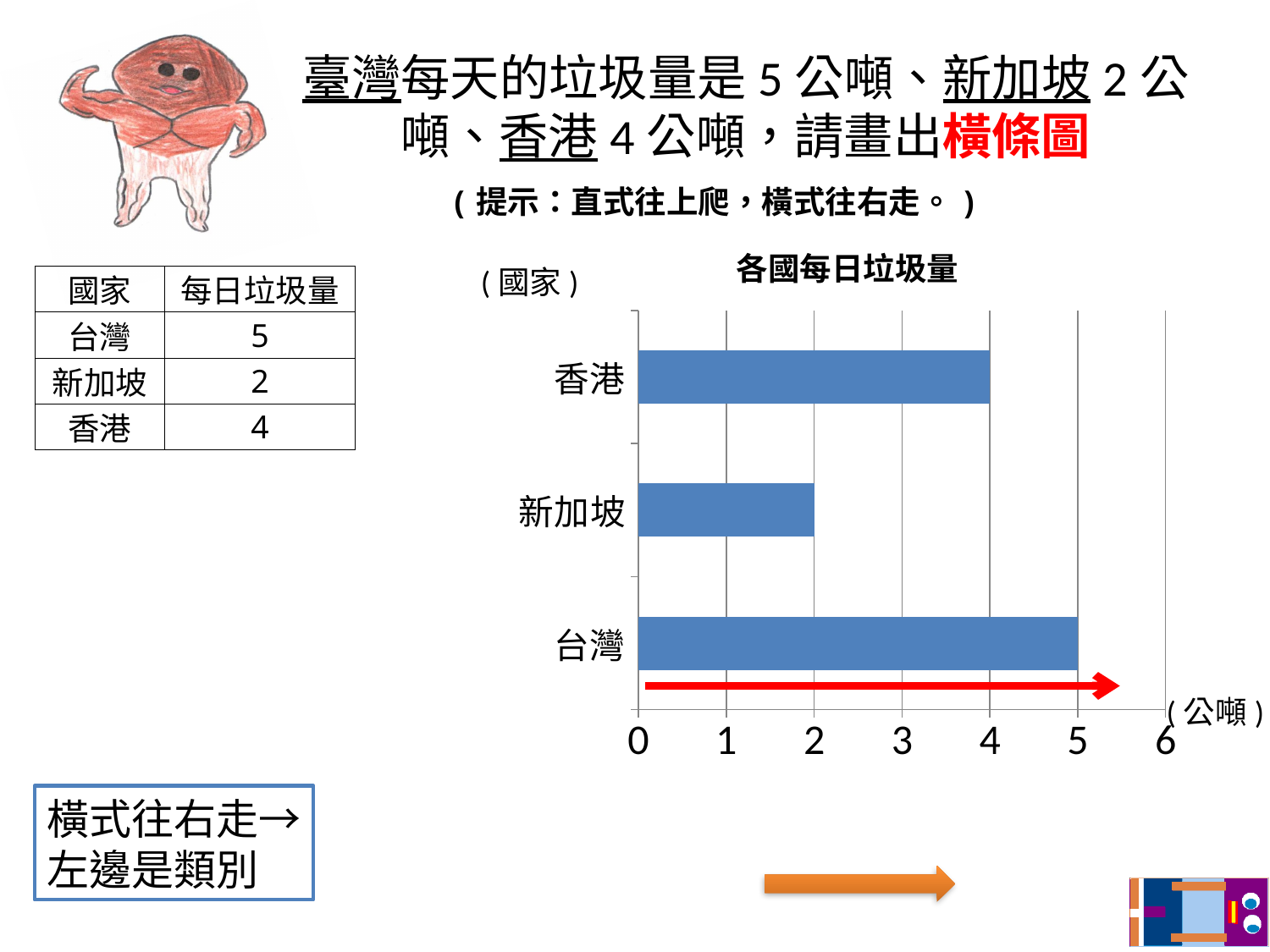
What is the title of the chart? 各國每日垃圾量 What type of chart is shown on the slide? bar chart How many countries are plotted in the chart? 3 What is the daily garbage amount for 新加坡 in the chart? 2 What is the daily garbage amount for 台灣 in the chart? 5 Is the value for 香港 greater or less than 3? greater Which country has the lowest daily garbage amount in the chart? 新加坡 Which country has the highest daily garbage amount in the chart? 台灣 Which has a larger daily garbage amount, 香港 or 新加坡? 香港 What is the difference between the daily garbage amounts of 台灣 and 新加坡? 3 What is the daily garbage amount for 香港 in the chart? 4 What unit is shown at the end of the horizontal axis of the chart? 公噸